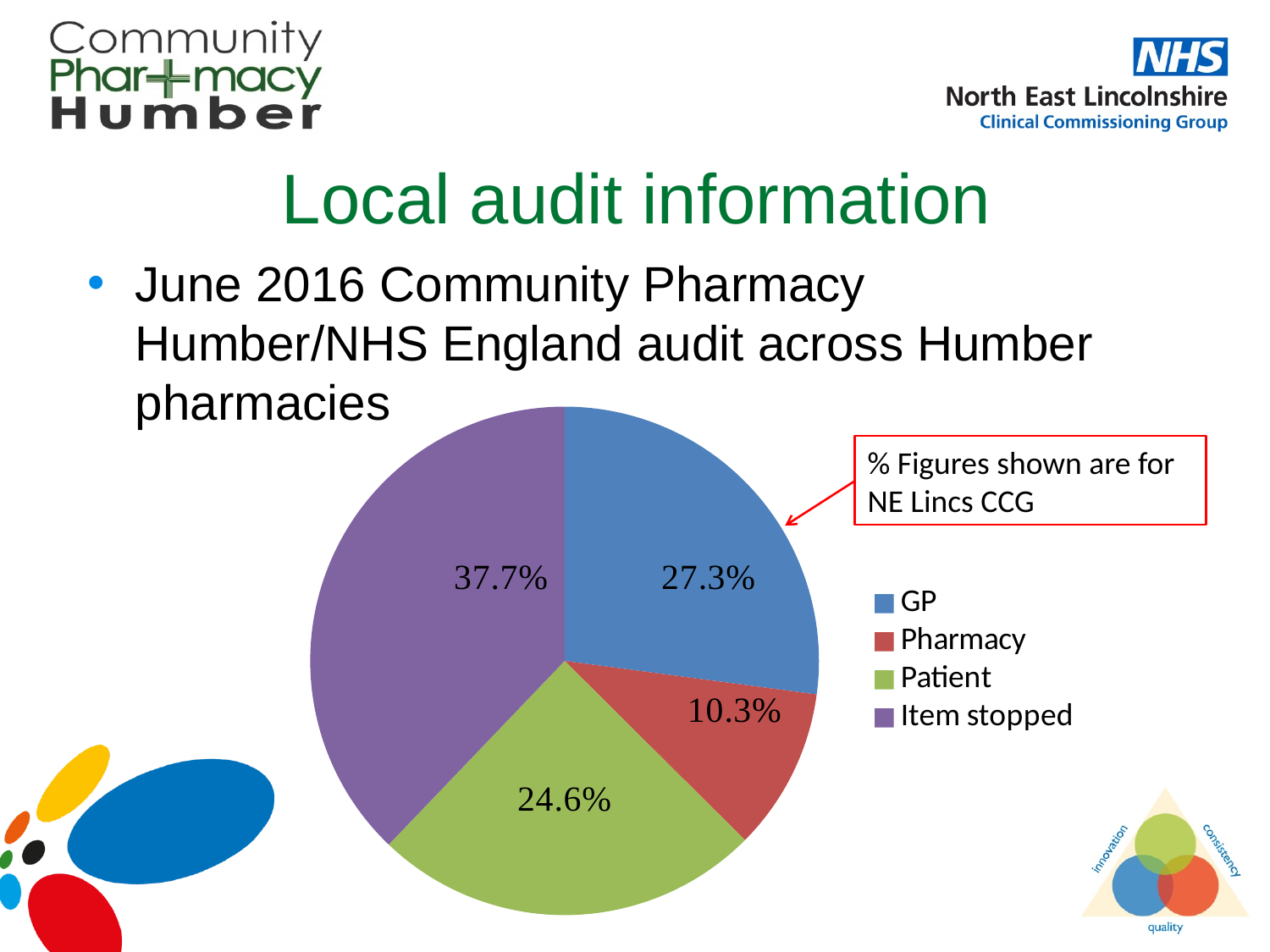
What colour is the Item stopped slice? purple Which category has the largest share of the pie? Item stopped What is the difference between the Item stopped share and the GP share? 10.4% How many categories does the pie chart show? 4 What percentage is shown for Pharmacy? 10.3% What percentage is shown for GP? 27.3% What kind of chart is shown on the slide? pie chart Which is larger, the share for GP or the share for Patient? GP Which category has the smallest share of the pie? Pharmacy According to the text box, which CCG do the % figures shown relate to? NE Lincs CCG What percentage is shown for Item stopped? 37.7% What percentage is shown for Patient? 24.6%